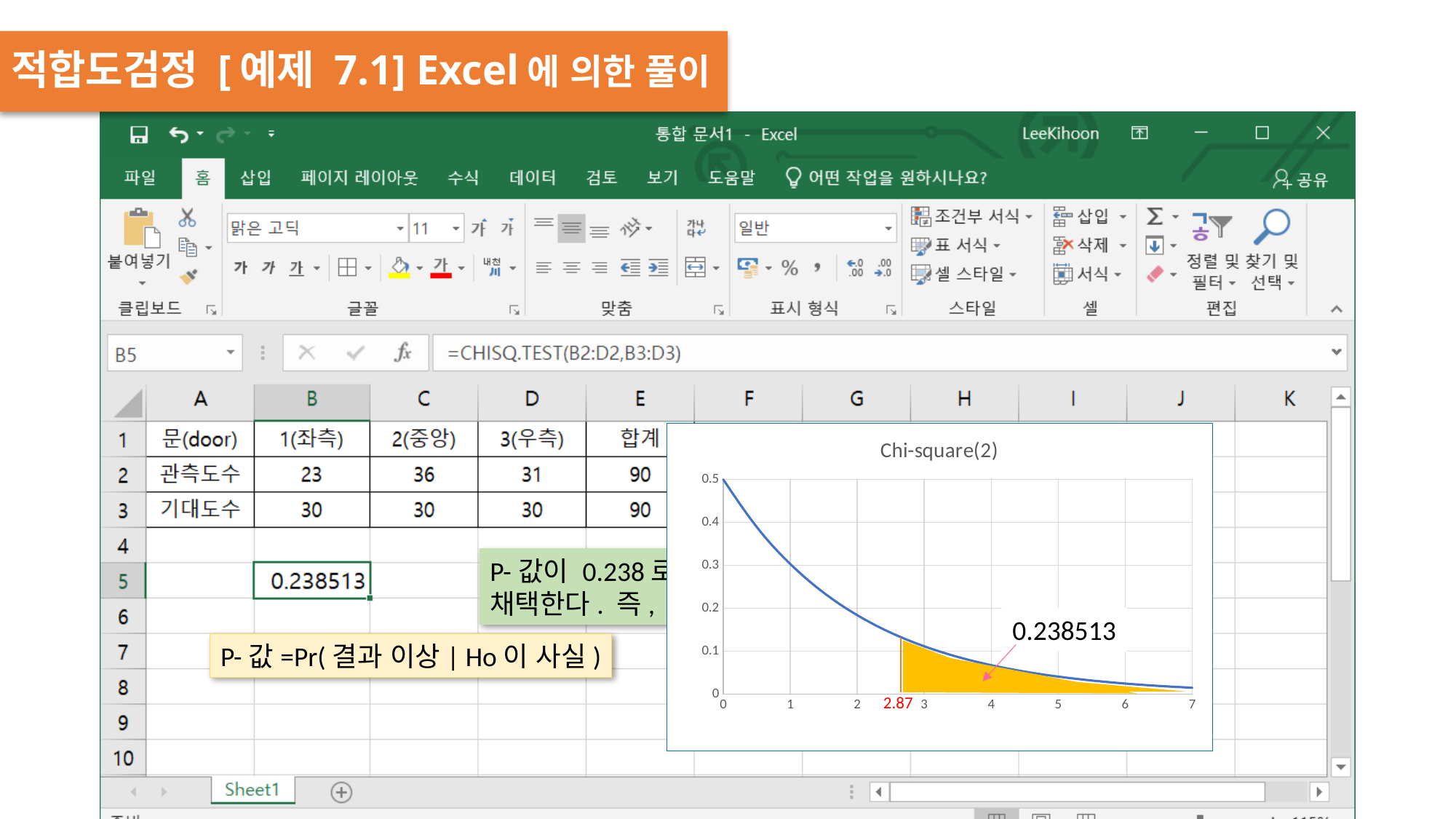
In the Chi-square(2) chart, what is the value of the curve at x = 0? 0.5 What x-axis value is marked in red in the Chi-square(2) chart, where the shaded area begins? 2.87 What kind of chart is the Chi-square(2) chart? line chart In the Chi-square(2) chart, is the value of the curve at x = 1 greater or less than 0.2? greater In the Chi-square(2) chart, is the value of the curve at x = 6 greater or less than 0.1? less What is the title of the chart on the slide? Chi-square(2) In the Chi-square(2) chart, is the value of the curve at x = 1 greater or less than 0.4? less In the Chi-square(2) chart, which is larger: the value of the curve at x = 1 or at x = 5? x = 1 What value is printed as the label for the shaded area in the Chi-square(2) chart? 0.238513 What is the highest value shown on the y axis of the Chi-square(2) chart? 0.5 In the Chi-square(2) chart, do the values rise or fall as x increases? fall